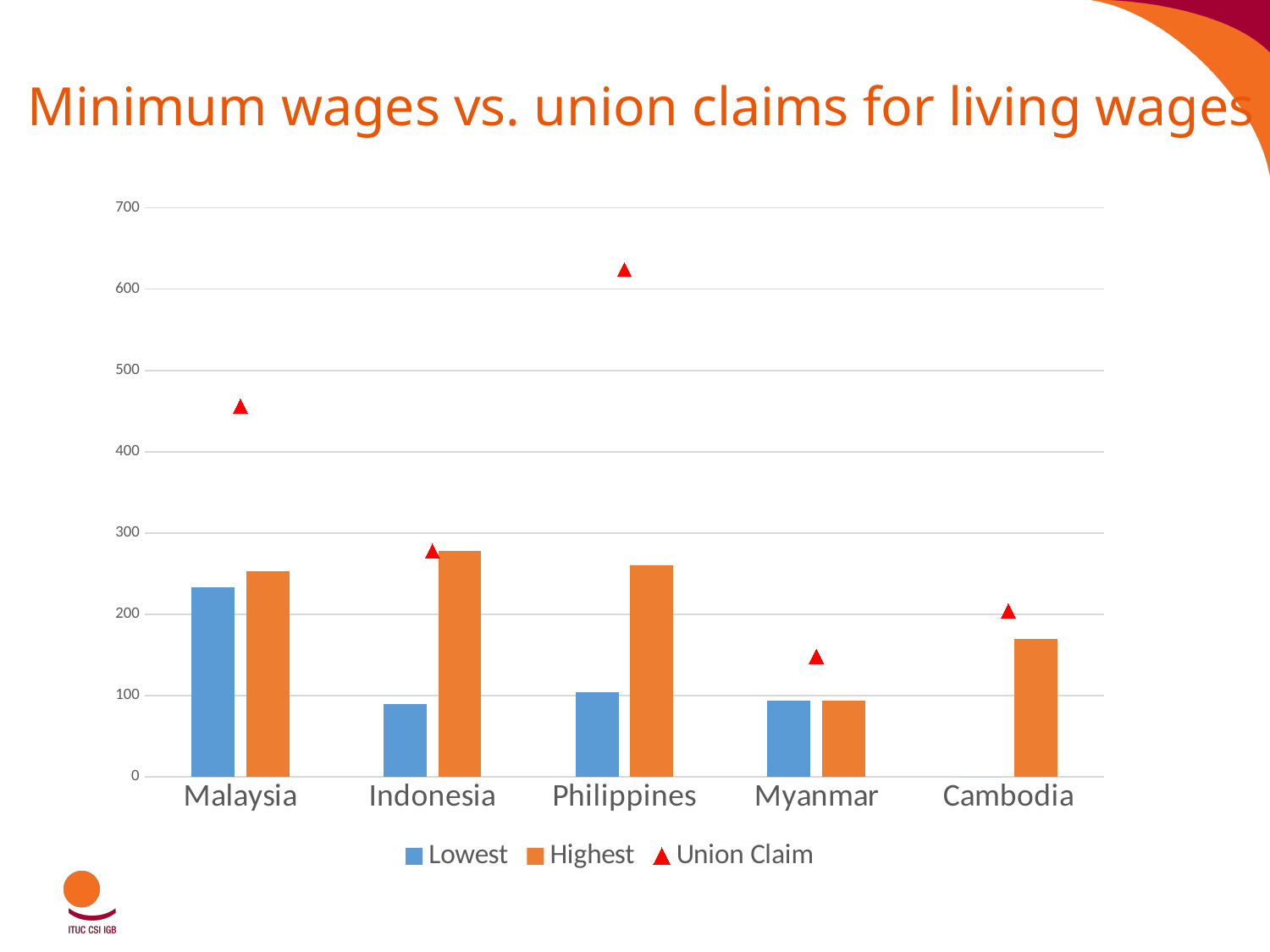
Is the Union Claim value for Malaysia greater or less than 400? greater Which country has the highest Lowest minimum wage bar? Malaysia How many series does the legend list? 3 How many countries are shown on the x axis? 5 Which is larger, the Lowest bar for Malaysia or the Lowest bar for Indonesia? Malaysia Which country has the highest Union Claim value? Philippines What is the title of the slide? Minimum wages vs. union claims for living wages Which country has the lowest Union Claim value? Myanmar Is the Highest bar for Cambodia greater or less than 200? less Is the Union Claim value for Philippines greater or less than 600? greater What kind of chart is shown on the slide? bar chart